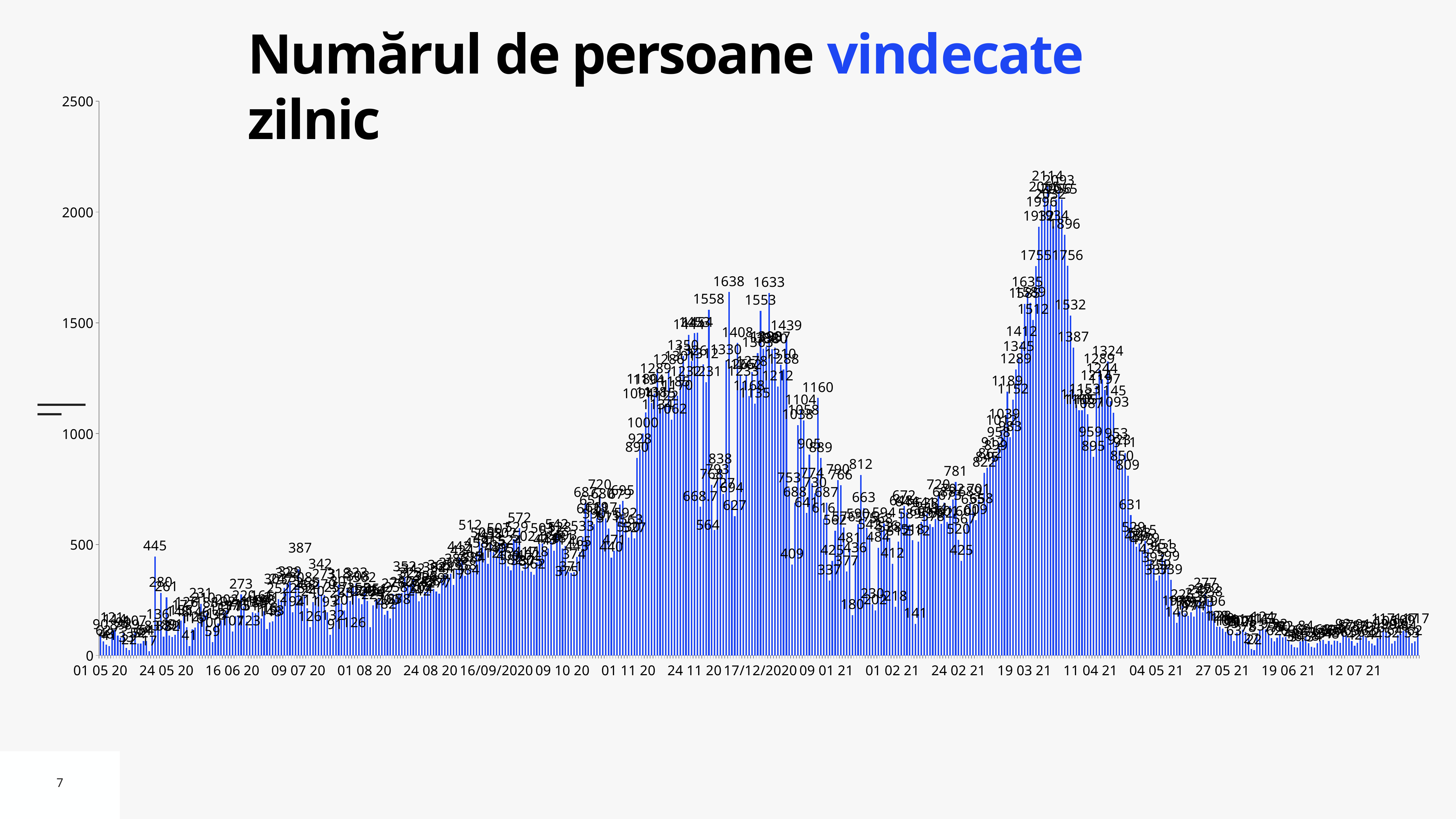
What kind of chart is shown on the slide? bar chart What is the value of the tallest bar between 01 05 20 and 16 06 20? 445 What is the value of the tallest bar between 16 06 20 and 01 08 20? 387 What is the difference between the tallest bar (2114) and the bar labeled 1638? 476 Is the value for the first bar at 01 05 20 greater or less than 500? less What is the title of the chart? Numărul de persoane vindecate zilnic Is the value of the tallest bar greater or less than 2000? greater Do the values rise or fall between 24 02 21 and 19 03 21? rise Do the values rise or fall between 11 04 21 and 04 05 21? fall What is the value of the tallest bar in the chart? 2114 What is the highest value shown on the y axis? 2500